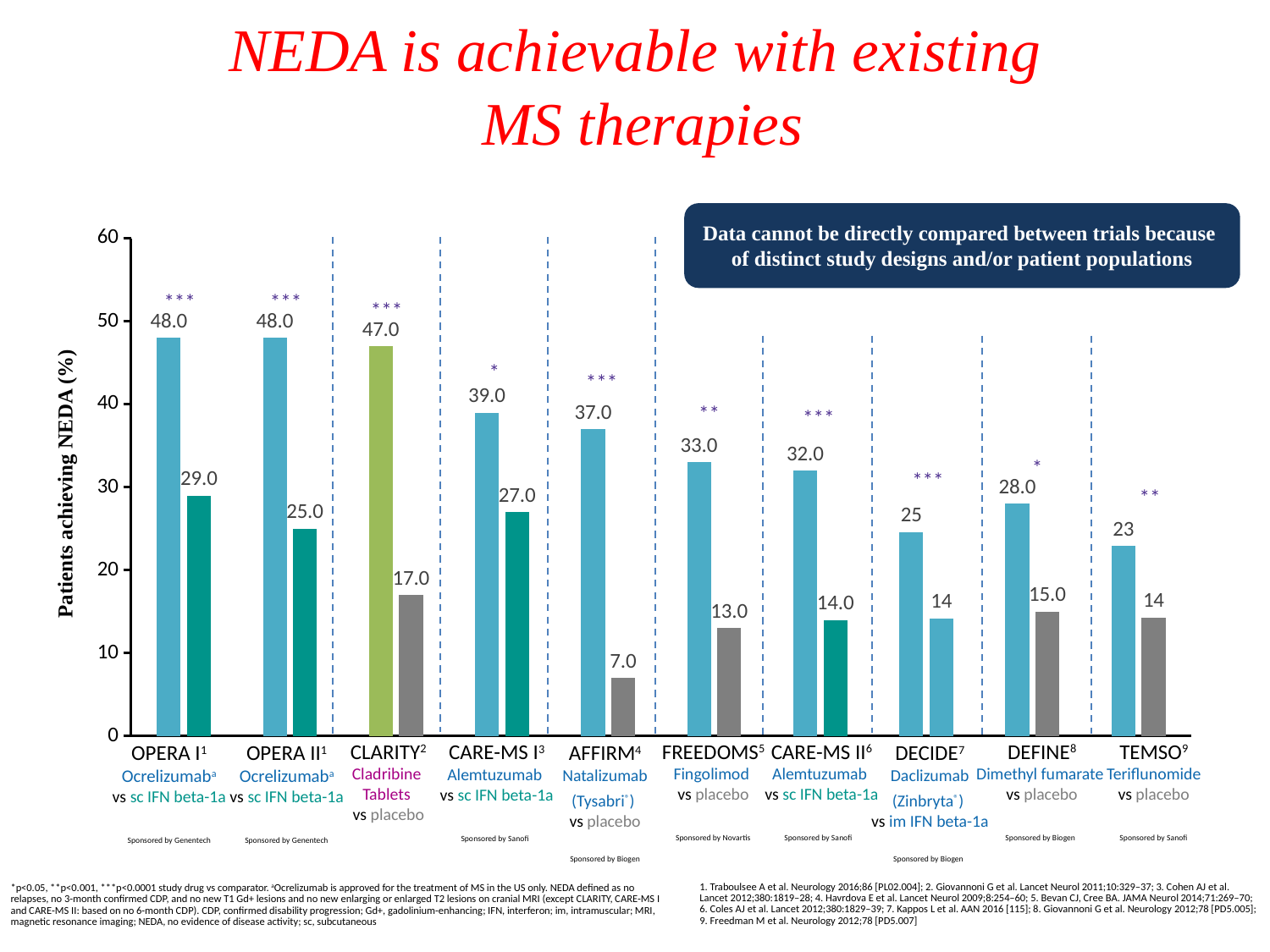
What type of chart is shown on the slide? bar chart What percentage of patients achieved NEDA with the study drug in the CLARITY trial? 47.0 Which is larger: the study drug value for CARE-MS I or the study drug value for FREEDOMS? CARE-MS I What is the label of the y axis? Patients achieving NEDA (%) Which trial has the lowest comparator bar? AFFIRM What is the difference between the study drug and comparator values in the OPERA I trial? 19.0 What is the comparator value for the DEFINE trial? 15.0 What is the study drug value shown for the DECIDE trial? 25 What is the comparator (placebo) value for the AFFIRM trial? 7.0 What is the difference between the study drug and comparator values in the AFFIRM trial? 30.0 How many trials are shown on the x axis of the chart? 10 Is the study drug value for TEMSO greater or less than 30? less